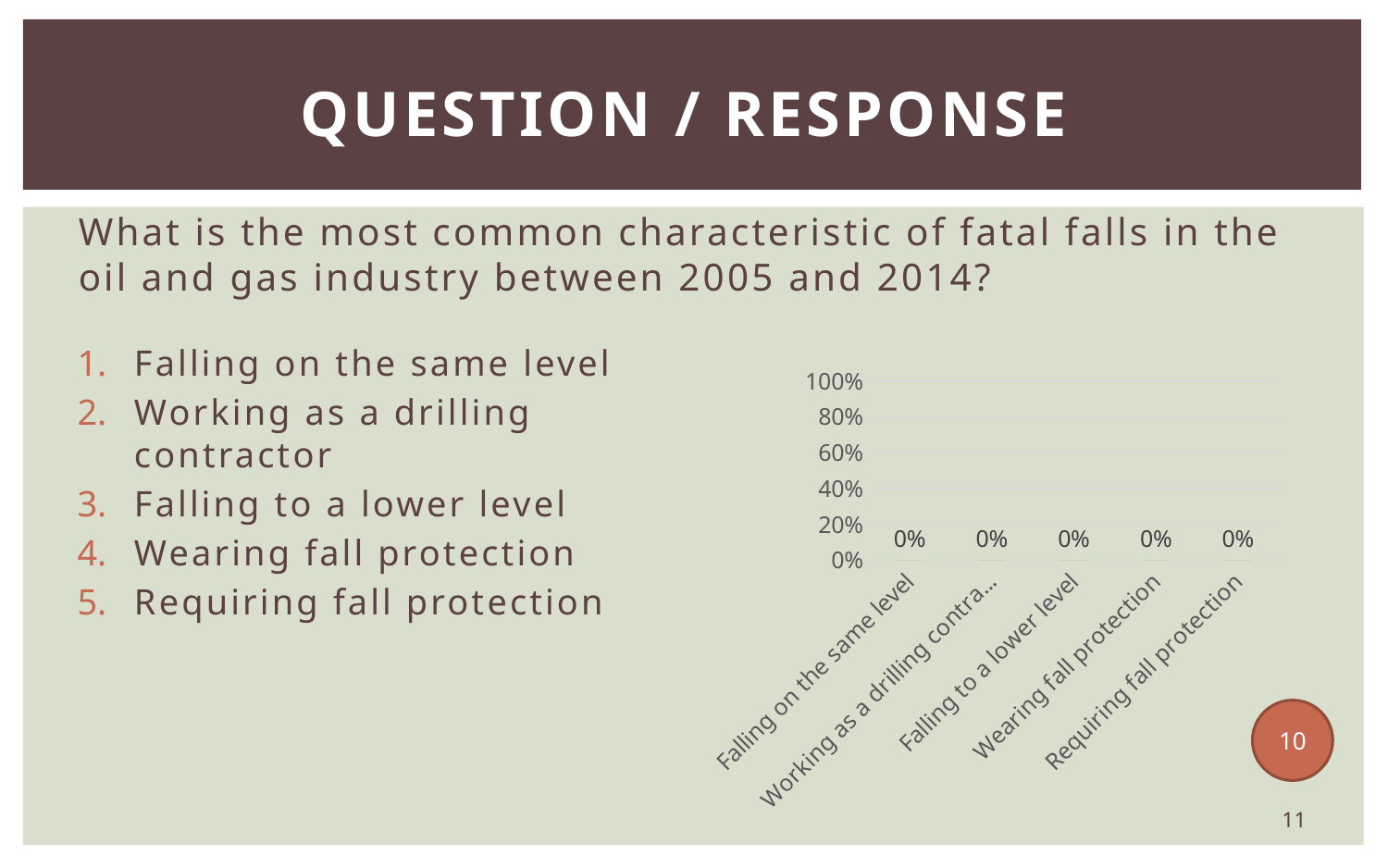
What is the value for Requiring fall protection? 0% What is the difference between the values for Wearing fall protection and Requiring fall protection? 0% What is the value for Falling on the same level? 0% How many categories are shown on the chart? 5 What kind of chart is shown on the slide? bar chart What is the label of the first category on the chart's horizontal axis? Falling on the same level Is the value for Falling on the same level greater or less than 40%? less Do the values rise, fall, or stay flat across the categories from left to right? stay flat What is the value for Falling to a lower level? 0% What is the value for Wearing fall protection? 0% What is the highest value shown on the chart's vertical axis? 100% Is the value for Falling to a lower level greater or less than 20%? less